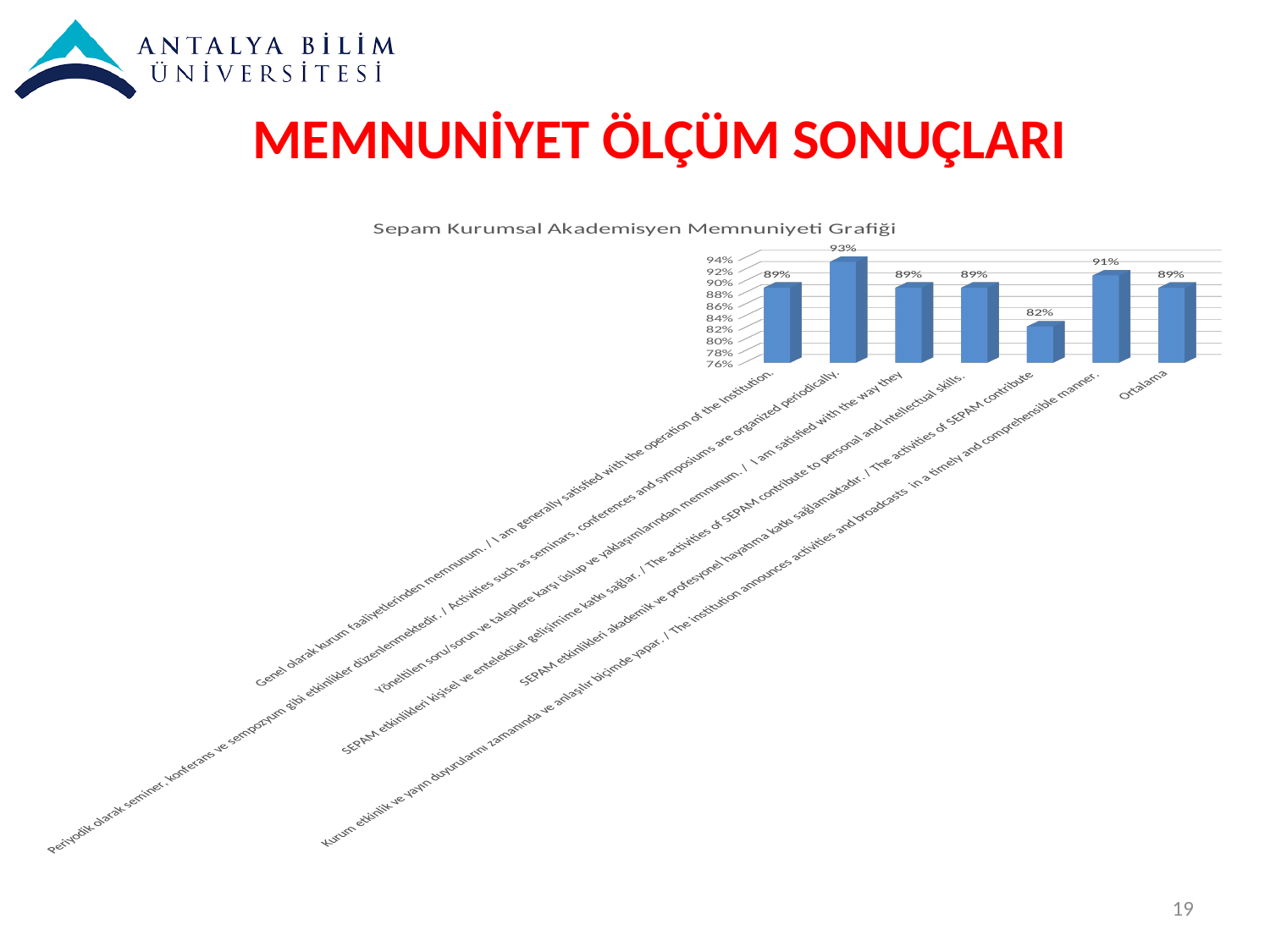
What is the title of the chart? Sepam Kurumsal Akademisyen Memnuniyeti Grafiği Which is larger: the value for "The institution announces activities and broadcasts in a timely and comprehensible manner" or the value for "Ortalama"? The institution announces activities and broadcasts in a timely and comprehensible manner What is the lowest value shown in the chart? 82% Which category has the highest value? Activities such as seminars, conferences and symposiums are organized periodically How many bars are shown in the chart? 7 What is the value for the category "Activities such as seminars, conferences and symposiums are organized periodically"? 93% What is the value for "Ortalama"? 89% Is the lowest bar's value greater or less than 84%? less What is the value for the category "The institution announces activities and broadcasts in a timely and comprehensible manner"? 91% What is the difference between the highest value (93%) and the lowest value (82%)? 11% What type of chart is shown on the slide? Bar chart What is the value for the category "I am generally satisfied with the operation of the Institution"? 89%